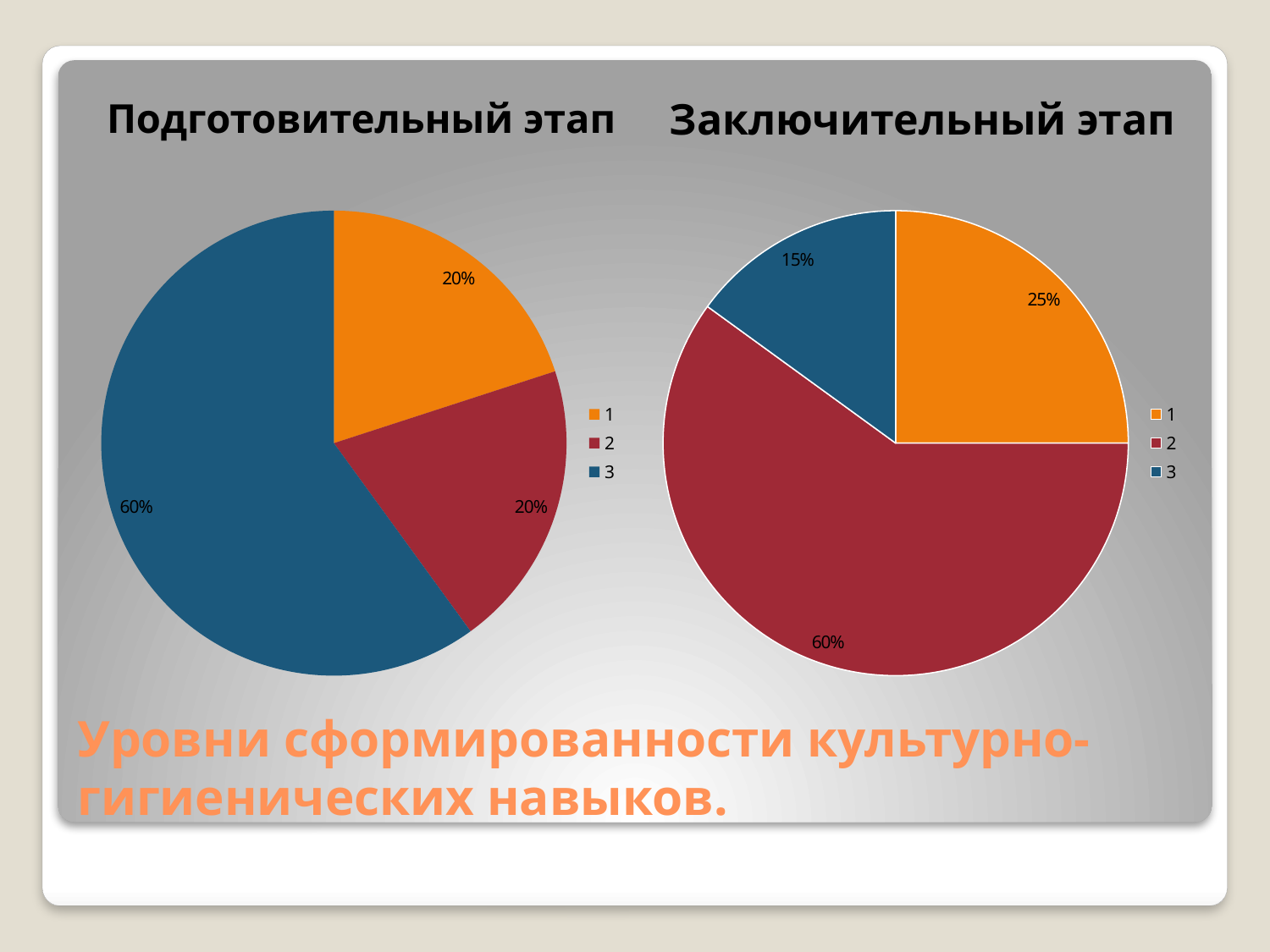
What type of chart is the "Подготовительный этап" chart? pie chart How many slices does the "Заключительный этап" chart have? 3 In the "Заключительный этап" chart, which category has the largest slice? 2 In the "Заключительный этап" chart, what is the difference between the shares of category 2 and category 1? 35% In the "Заключительный этап" chart, what share does category 1 have? 25% In the "Заключительный этап" chart, what share does category 3 have? 15% In the "Заключительный этап" chart, which is larger: the share of category 1 or category 3? 1 In the "Заключительный этап" chart, which category has the smallest slice? 3 What colour is the slice for category 2 in the "Заключительный этап" chart? dark red In the "Подготовительный этап" chart, what share does category 3 have? 60% How many entries does the legend of the "Подготовительный этап" chart list? 3 In the "Подготовительный этап" chart, which category has the largest slice? 3